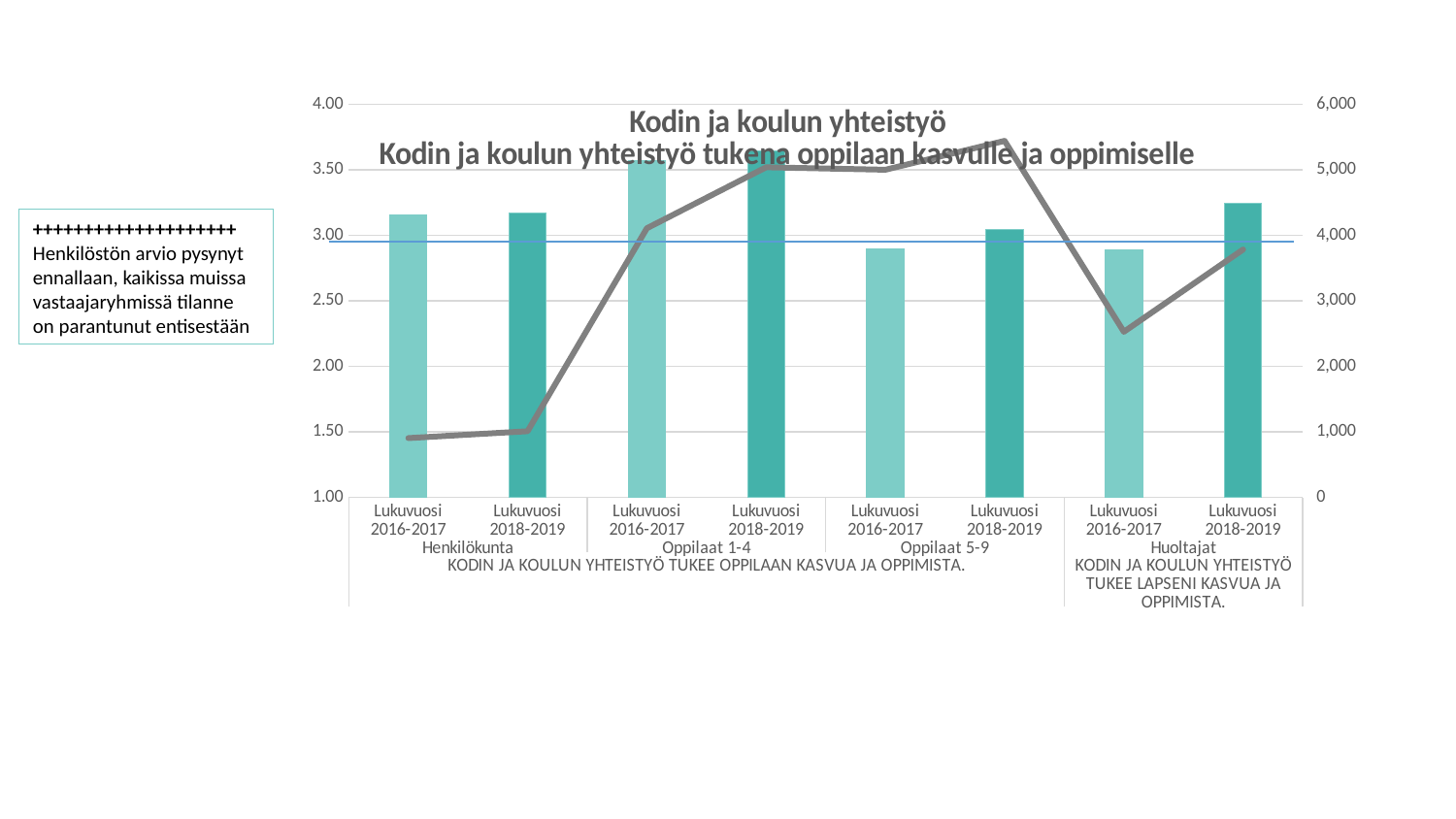
How many respondent groups (Henkilökunta, Oppilaat 1-4, Oppilaat 5-9, Huoltajat) are shown on the x axis? 4 What is the first line of the chart title? Kodin ja koulun yhteistyö How many bars are plotted in the chart? 8 Is the line value for Huoltajat Lukuvuosi 2016-2017 greater or less than 3,000 on the right axis? less Is the bar for Oppilaat 1-4 Lukuvuosi 2016-2017 greater or less than 3.50 on the left axis? greater What kind of chart is shown on the slide? A bar chart with a line At which category does the line reach its highest point? Oppilaat 5-9, Lukuvuosi 2018-2019 Is the bar for Huoltajat Lukuvuosi 2016-2017 greater or less than 3.00 on the left axis? less Which bar is larger for Huoltajat: Lukuvuosi 2016-2017 or Lukuvuosi 2018-2019? Lukuvuosi 2018-2019 Which bar is larger for Oppilaat 5-9: Lukuvuosi 2016-2017 or Lukuvuosi 2018-2019? Lukuvuosi 2018-2019